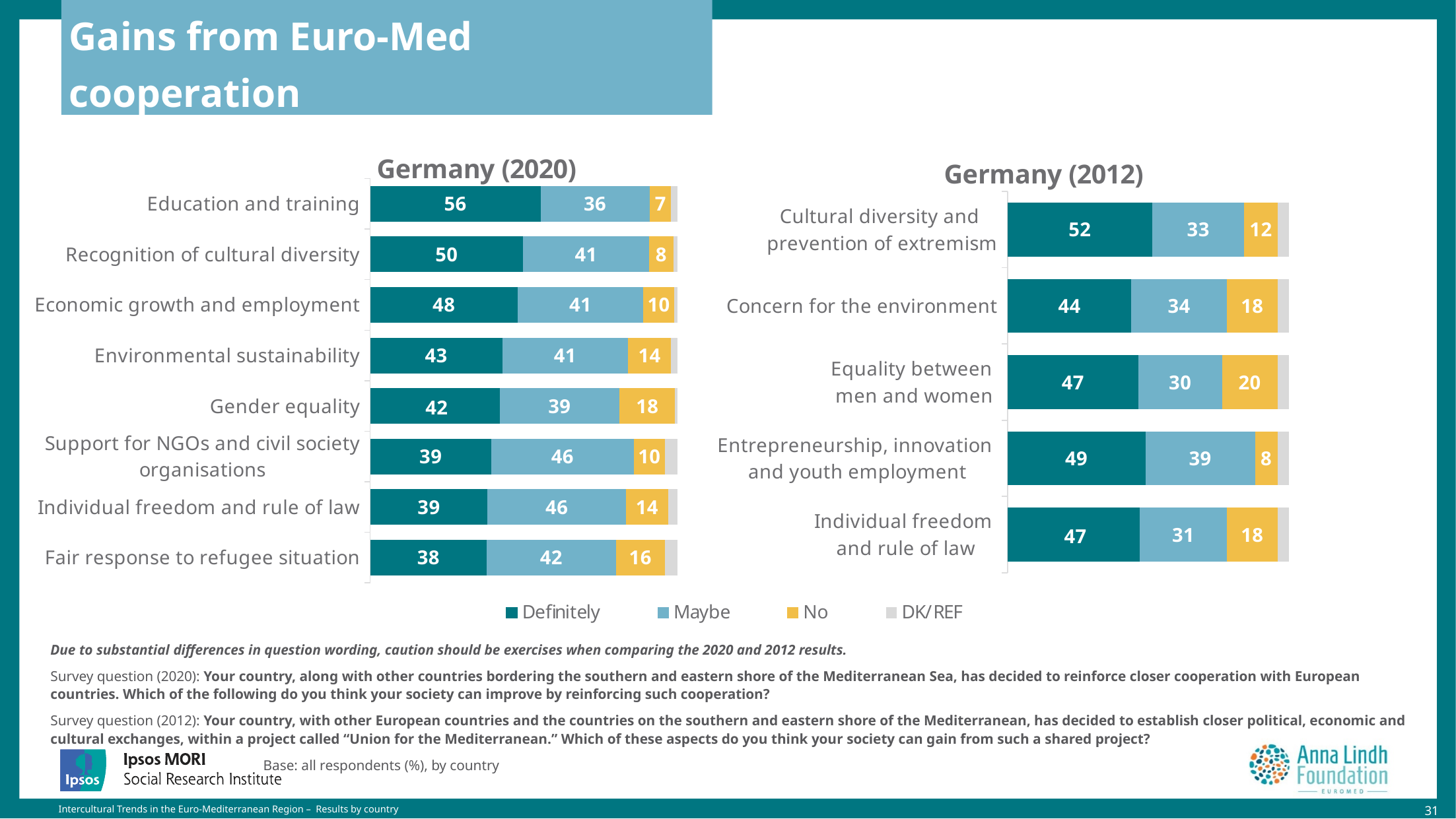
How many categories are shown in the Germany (2020) chart? 8 In the Germany (2012) chart, what is the Maybe value for Concern for the environment? 34 How many categories are shown in the Germany (2012) chart? 5 In the Germany (2012) chart, what is the No value for Entrepreneurship, innovation and youth employment? 8 In the Germany (2012) chart, is the Definitely value for Cultural diversity and prevention of extremism larger than the Definitely value for Equality between men and women? Yes In the Germany (2020) chart, what is the No value for Gender equality? 18 What type of chart is the Germany (2012) chart? Stacked bar chart In the Germany (2020) chart, what is the Definitely value for Education and training? 56 In the Germany (2020) chart, which category has the highest Definitely value? Education and training In the Germany (2012) chart, which category has the lowest Definitely value? Concern for the environment How many series does the legend list? 4 In the Germany (2020) chart, what is the difference between the Definitely values for Education and training and Fair response to refugee situation? 18